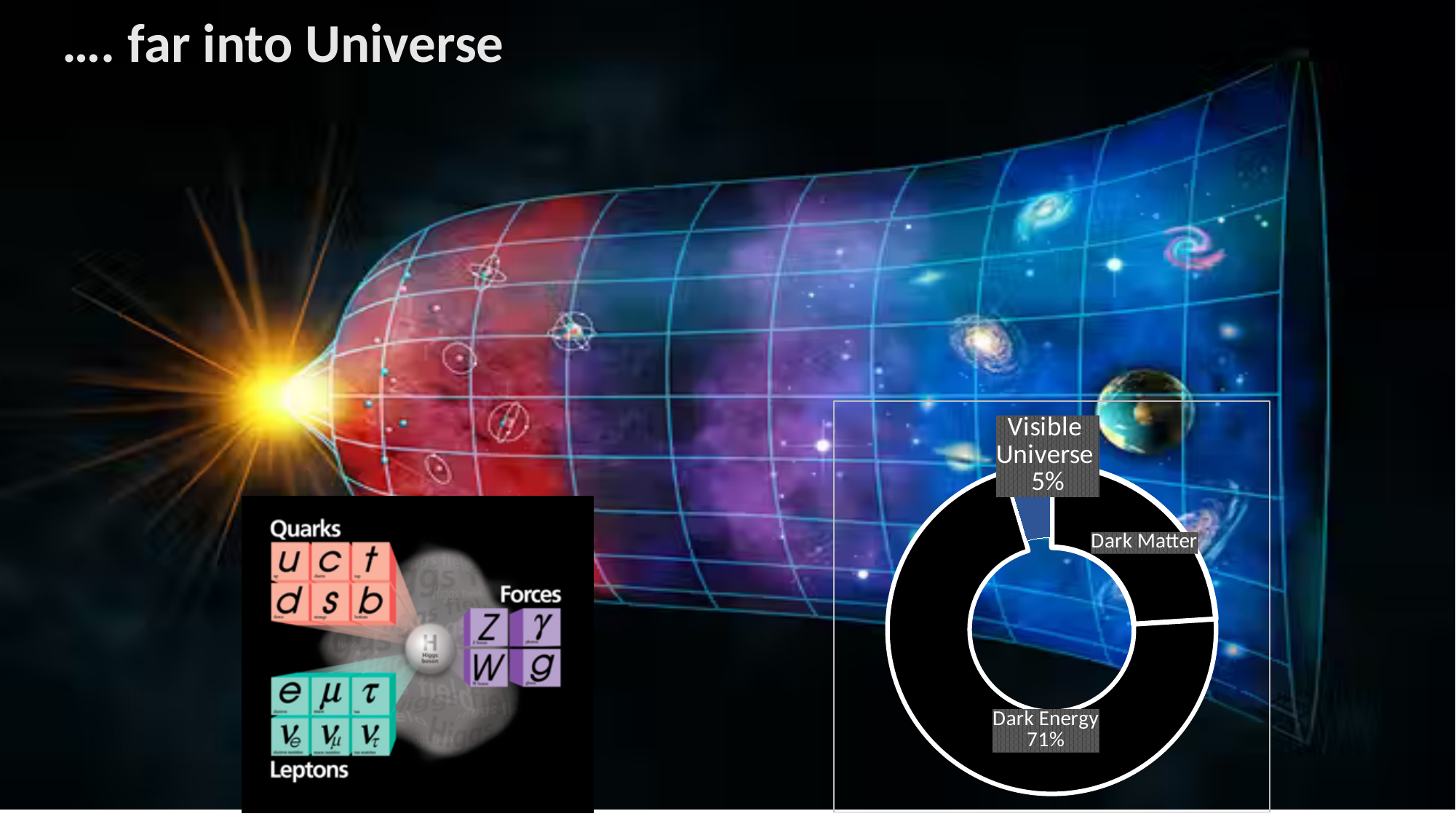
What colour is the Visible Universe slice in the doughnut chart? blue Which slice of the doughnut chart is the smallest? Visible Universe What percentage does the chart give for Visible Universe? 5% What percentage does the chart give for Dark Energy? 71% Which is larger in the doughnut chart, Dark Matter or Visible Universe? Dark Matter Which is larger in the doughnut chart, Dark Energy or Dark Matter? Dark Energy Which slice of the doughnut chart is the largest? Dark Energy What colour is the Dark Energy slice in the doughnut chart? black How many slices does the doughnut chart have? 3 By how many percentage points does Dark Energy exceed Visible Universe in the chart? 66 What kind of chart is shown in the bottom-right of the slide? doughnut chart